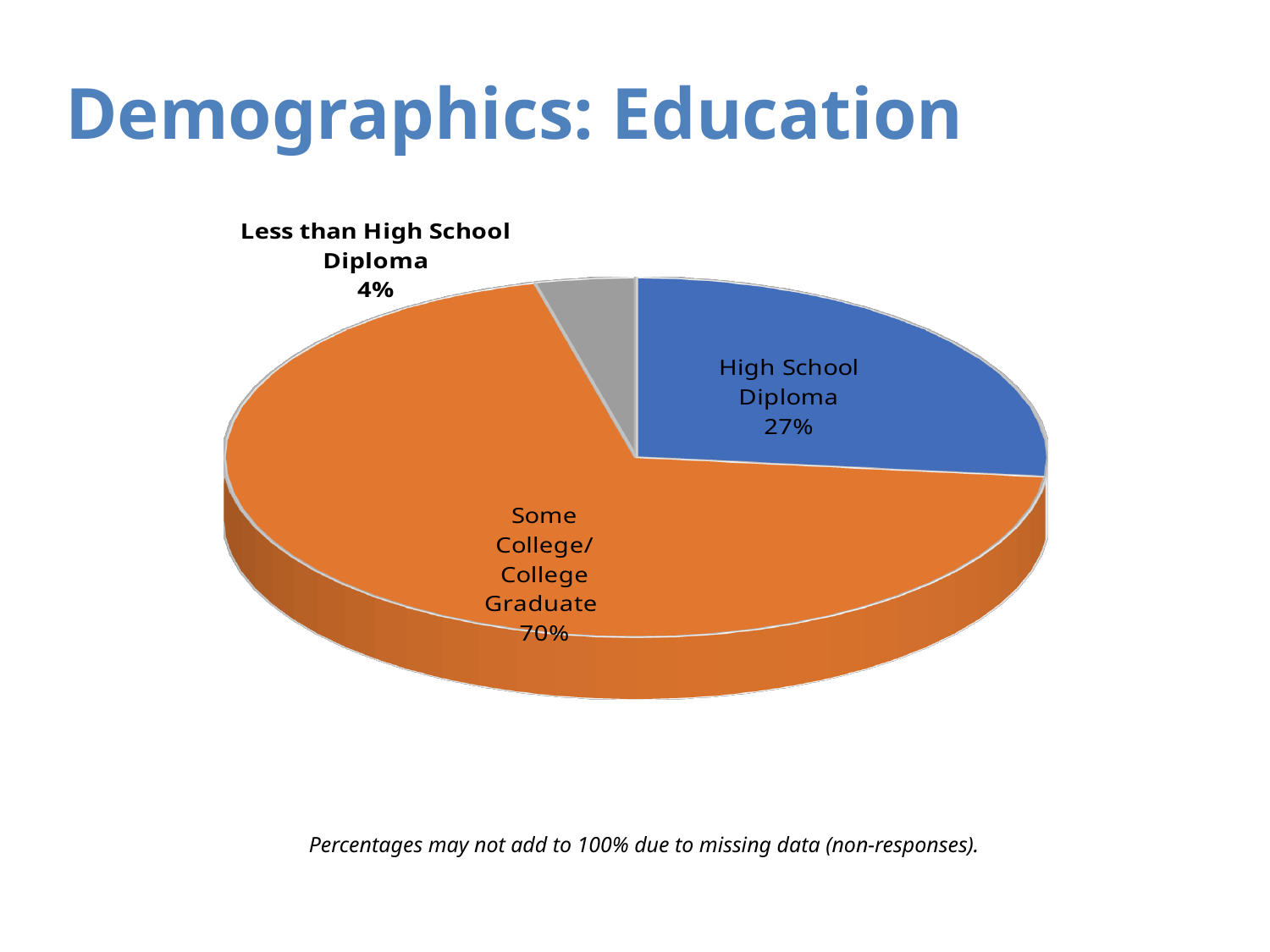
What is the difference in percentage points between High School Diploma and Less than High School Diploma? 23 What percentage of respondents have a High School Diploma? 27% Which education category has the smallest share of the pie? Less than High School Diploma How many education categories are shown in the pie chart? 3 Which education category has the largest share of the pie? Some College/College Graduate Which is larger: the share for High School Diploma or the share for Less than High School Diploma? High School Diploma What percentage of respondents have Less than High School Diploma? 4% What colour is the slice for Some College/College Graduate? Orange What is the difference in percentage points between Some College/College Graduate and High School Diploma? 43 What percentage of respondents are in the Some College/College Graduate category? 70% What kind of chart is shown on the slide? Pie chart What is the title of the slide? Demographics: Education